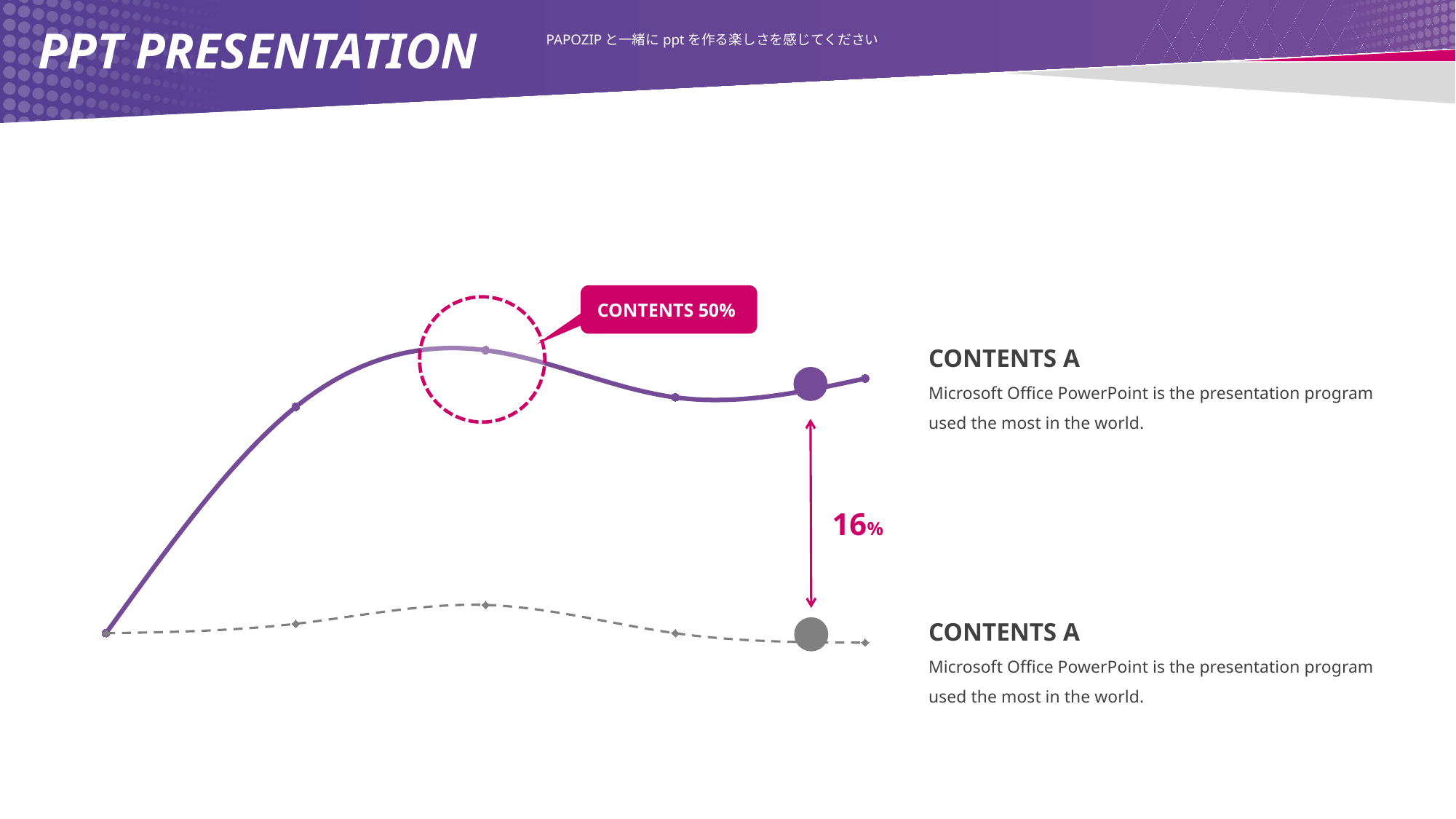
How many lines are plotted on the chart? 2 What percentage is shown in the callout label at the peak of the solid purple line? 50% Does the solid purple line rise or fall immediately after the point labelled CONTENTS 50%? fall Does the solid purple line rise or fall between its first point and its highest point? rise What kind of chart is shown on the slide? line chart What colour is the callout label reading CONTENTS 50%? pink/magenta Which line is higher at the right end of the chart, the solid purple line or the dashed gray line? solid purple line What percentage is shown for the gap between the solid purple line and the dashed gray line at the right side of the chart? 16% Which line is drawn with a dashed style? the gray line Which line reaches the highest point on the chart? solid purple line